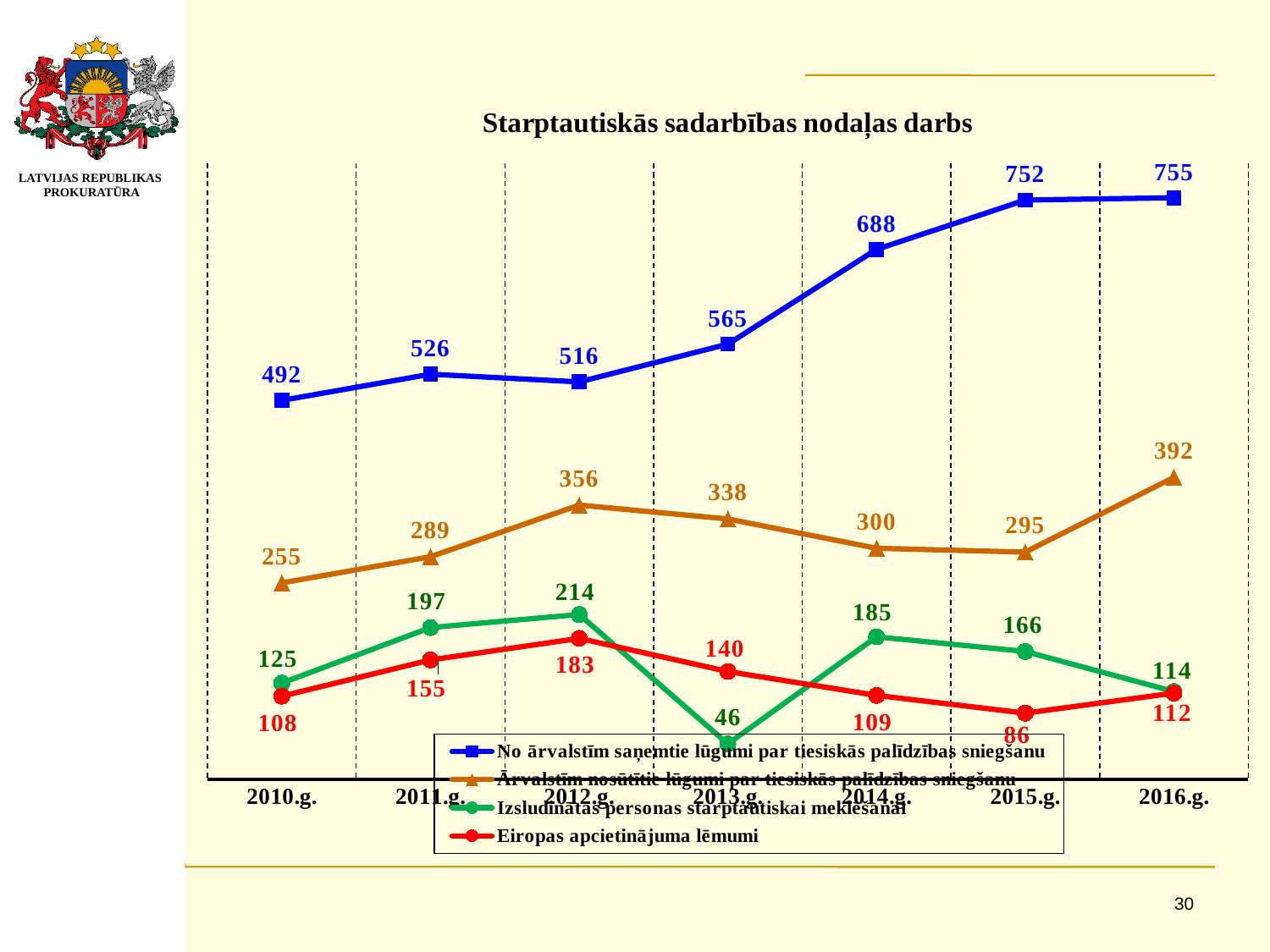
Which is larger in 2014.g.: the value for "Izsludinātās personas starptautiskai meklēšanai" or the value for "Eiropas apcietinājuma lēmumi"? Izsludinātās personas starptautiskai meklēšanai How many years are shown on the x axis of the chart? 7 What is the value for 2015.g. in the series "Eiropas apcietinājuma lēmumi"? 86 What kind of chart is shown on the slide? Line chart What is the value for 2013.g. in the series "Izsludinātās personas starptautiskai meklēšanai"? 46 What is the value for 2012.g. in the series "Ārvalstīm nosūtītie lūgumi par tiesiskās palīdzības sniegšanu"? 356 What is the value for 2014.g. in the series "No ārvalstīm saņemtie lūgumi par tiesiskās palīdzības sniegšanu"? 688 In which year is the series "No ārvalstīm saņemtie lūgumi par tiesiskās palīdzības sniegšanu" highest? 2016.g. What is the difference between the 2016.g. and 2010.g. values of the series "No ārvalstīm saņemtie lūgumi par tiesiskās palīdzības sniegšanu"? 263 What is the title of the chart? Starptautiskās sadarbības nodaļas darbs In which year is the series "Eiropas apcietinājuma lēmumi" lowest? 2015.g. How many series does the legend of the chart list? 4